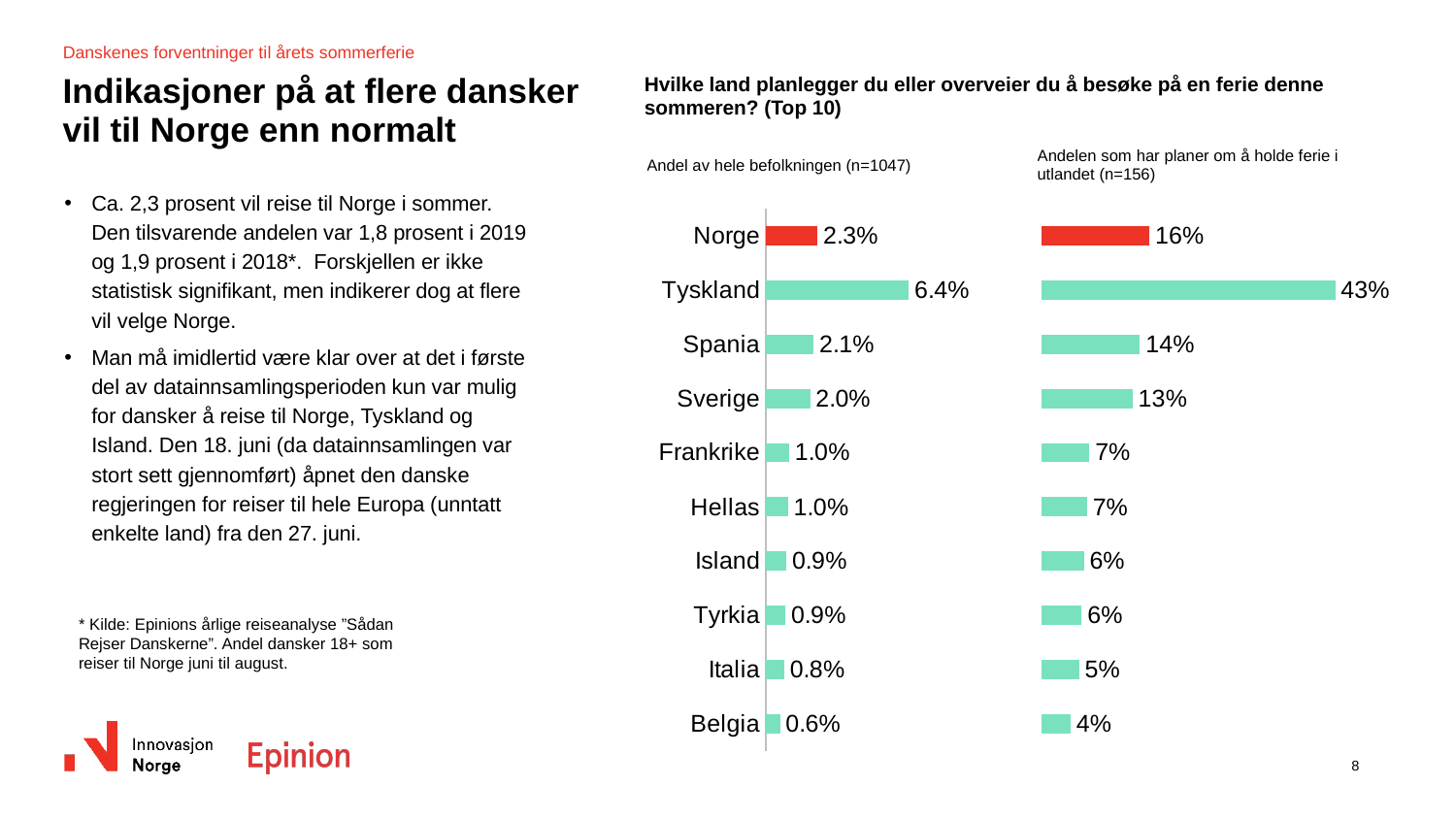
In the chart 'Andel av hele befolkningen (n=1047)', which is larger, the value for Spania or the value for Sverige? Spania In the chart 'Andel av hele befolkningen (n=1047)', what is the difference between the values for Tyskland and Norge? 4.1% In the chart 'Andelen som har planer om å holde ferie i utlandet (n=156)', what is the difference between the values for Norge and Spania? 2% In the chart 'Andelen som har planer om å holde ferie i utlandet (n=156)', what is the value for Tyskland? 43% What kind of chart is 'Andelen som har planer om å holde ferie i utlandet (n=156)'? Bar chart In the chart 'Andel av hele befolkningen (n=1047)', which country's bar is coloured red? Norge In the chart 'Andel av hele befolkningen (n=1047)', what is the value for Norge? 2.3% In the chart 'Andelen som har planer om å holde ferie i utlandet (n=156)', which is larger, the value for Sverige or the value for Frankrike? Sverige In the chart 'Andel av hele befolkningen (n=1047)', what is the value for Belgia? 0.6% In the chart 'Andelen som har planer om å holde ferie i utlandet (n=156)', which country has the lowest value? Belgia In the chart 'Andel av hele befolkningen (n=1047)', which country has the highest value? Tyskland How many countries are shown in the chart 'Andel av hele befolkningen (n=1047)'? 10